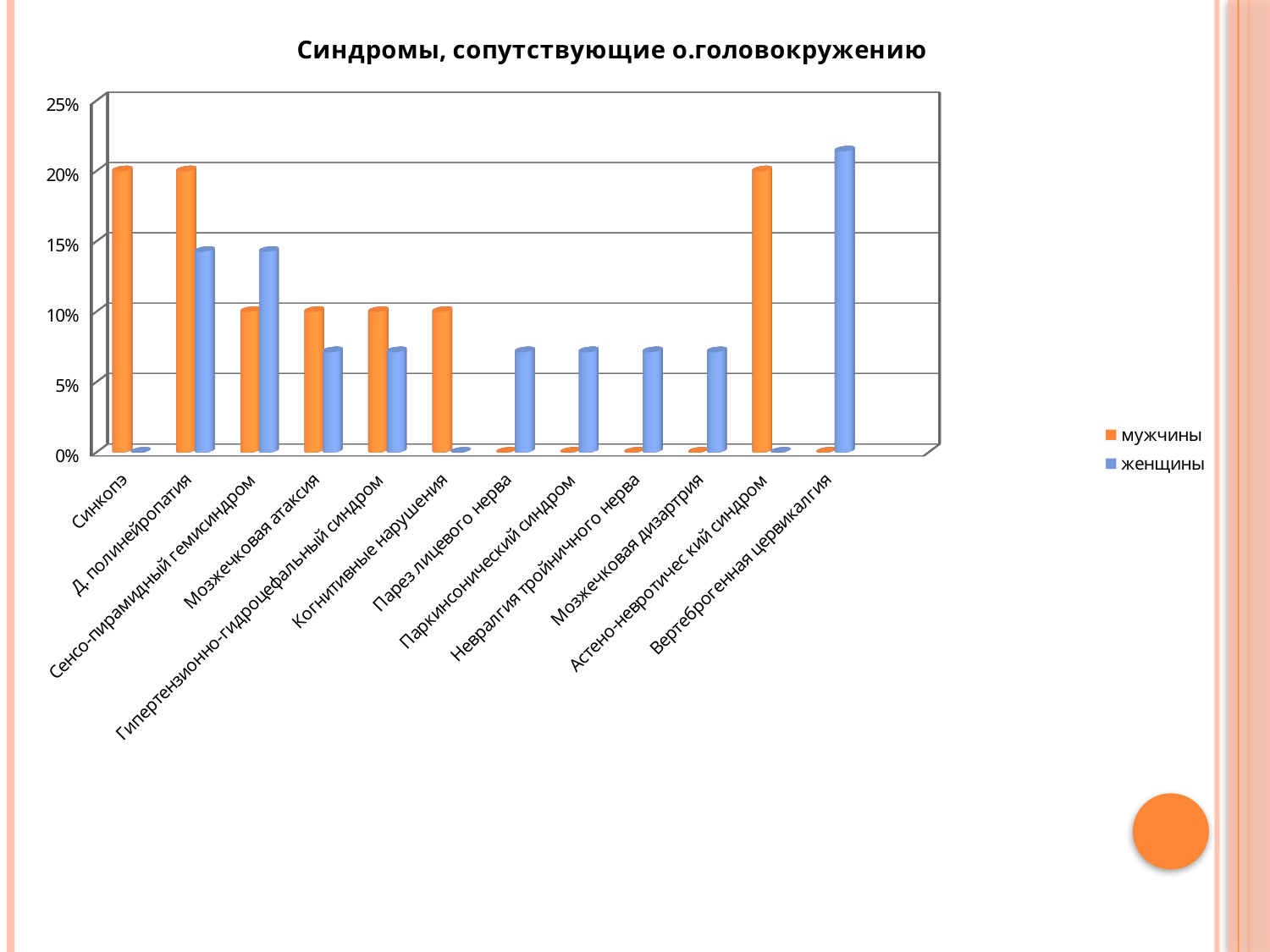
For Синкопэ, which series has the larger value, мужчины or женщины? мужчины Is the value for женщины in Вертеброгенная цервикалгия greater or less than 15%? greater How many categories are shown on the x axis? 12 What kind of chart is shown on the slide? bar chart How many series does the legend list? 2 Is the value for женщины in Сенсо-пирамидный гемисиндром greater or less than 10%? greater Is the value for мужчины in Синкопэ greater or less than 15%? greater Which category has the highest value for женщины? Вертеброгенная цервикалгия For Вертеброгенная цервикалгия, which series has the larger value, мужчины or женщины? женщины What is the title of the chart? Синдромы, сопутствующие о.головокружению Which colour represents the series женщины in the legend? blue